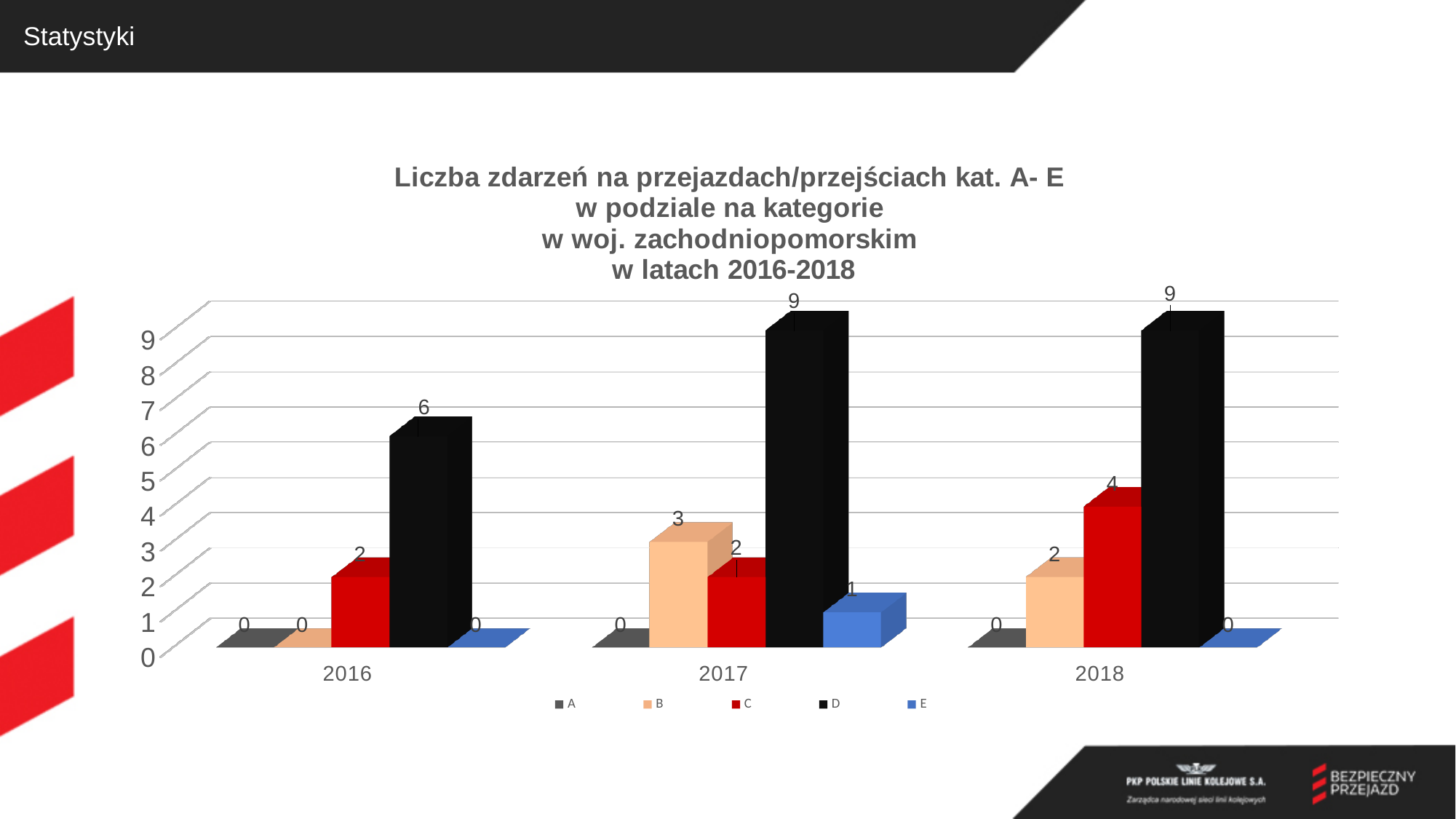
How many years are shown on the x axis? 3 What is the total of all series values in 2018? 15 In which year is the value for series D lowest? 2016 What kind of chart is shown on the slide? Bar chart What is the value for series D in 2017? 9 Which series has the highest value in 2016? D What is the difference between the value for series D in 2017 and in 2016? 3 Which is larger, the value for series C in 2018 or the value for series B in 2018? C in 2018 What is the value for series E in 2017? 1 What is the value for series B in 2017? 3 What is the value for series C in 2018? 4 How many series does the legend list? 5